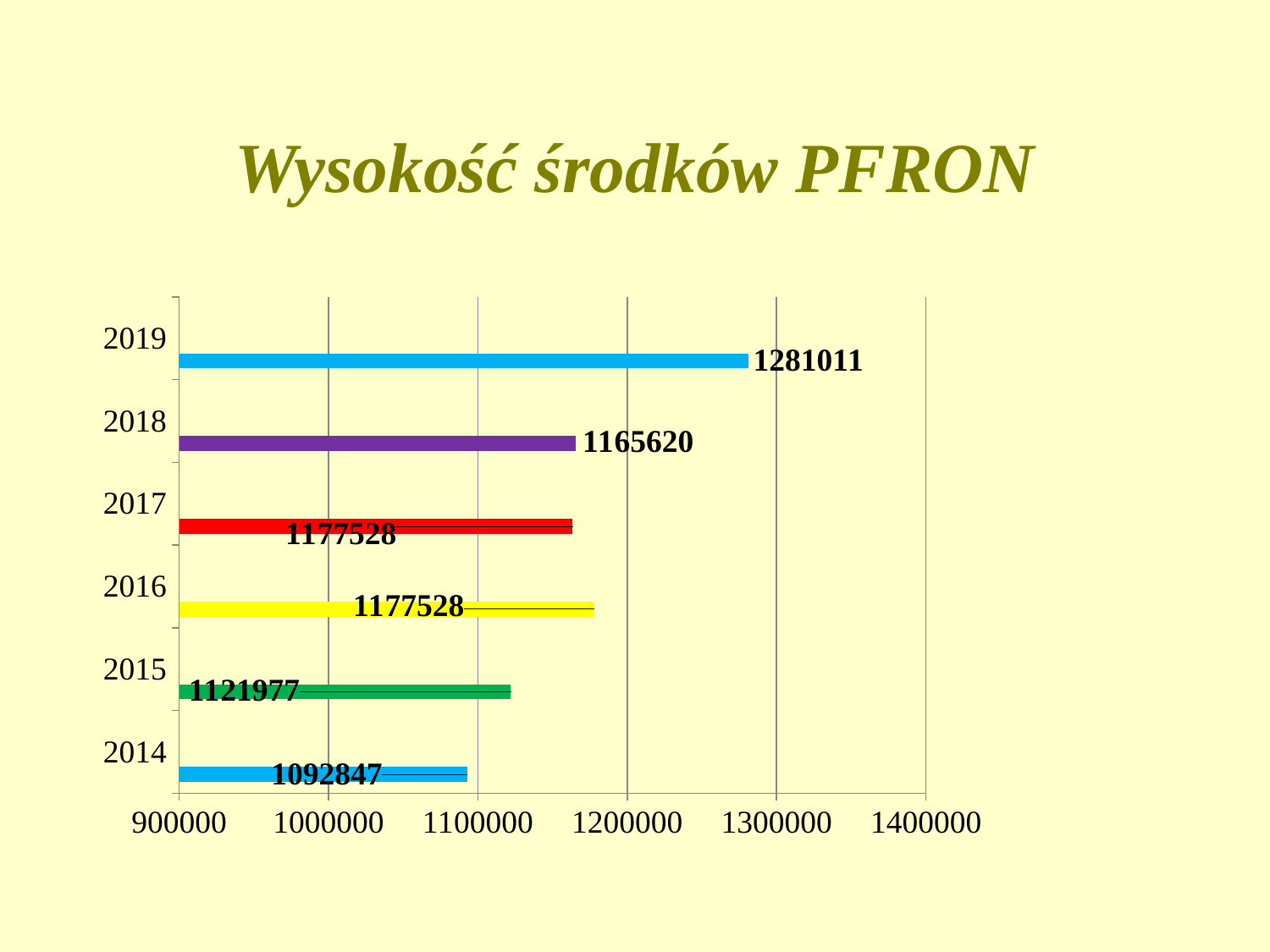
Which year has the lowest value? 2014 What is the value for 2015? 1121977 Which is larger, the value for 2019 or the value for 2018? 2019 What is the value for 2014? 1092847 How many years are shown in the chart? 6 What is the value for 2018? 1165620 Is the value for 2019 greater or less than 1200000? greater Which year has the highest value? 2019 What is the value for 2019? 1281011 What is the difference between the values for 2015 and 2014? 29130 What kind of chart is shown on the slide? bar chart What is the difference between the values for 2019 and 2018? 115391